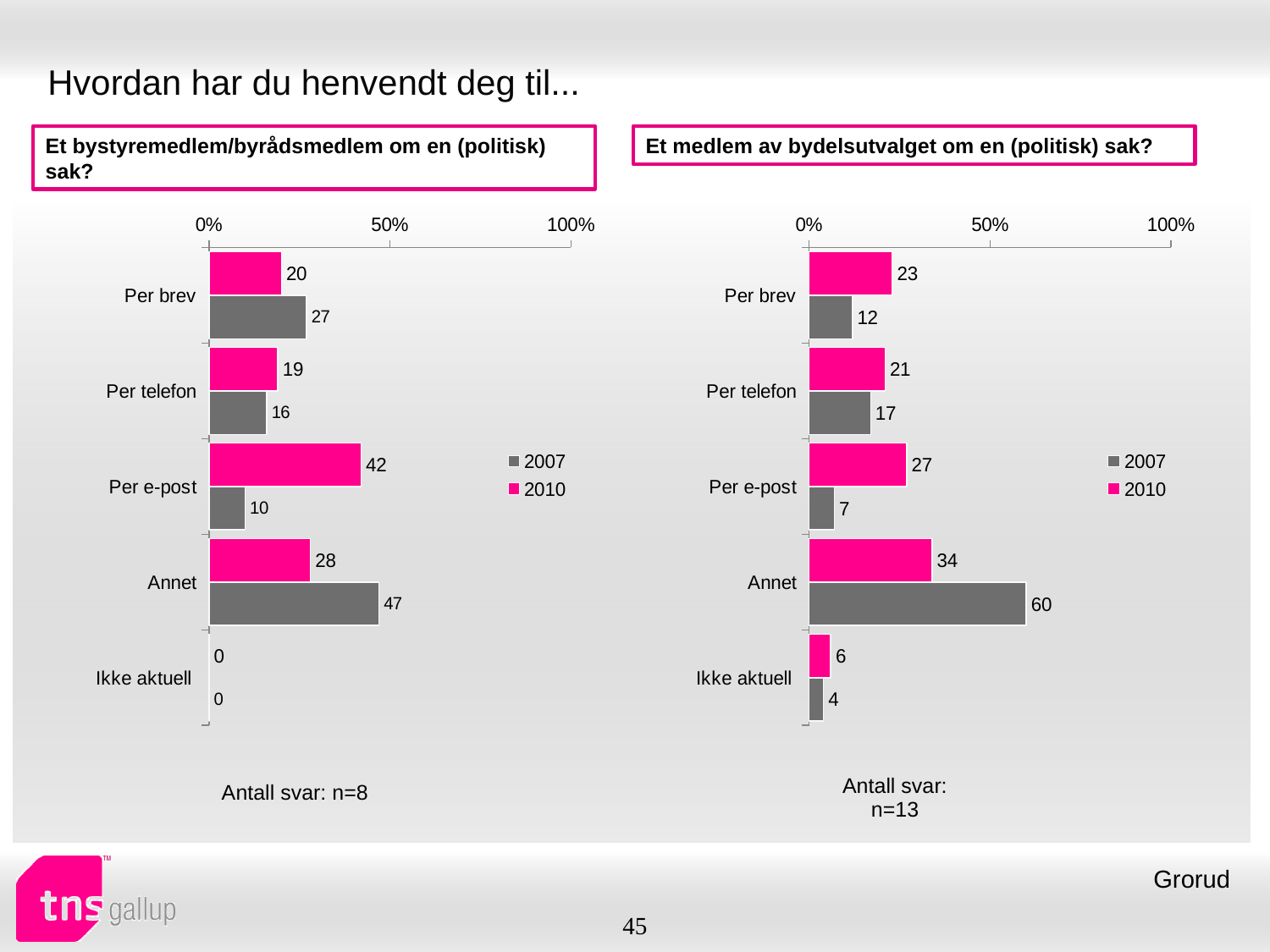
In the right chart (Et medlem av bydelsutvalget om en (politisk) sak?), which category has the lowest 2010 value? Ikke aktuell What is the number of respondents (Antall svar) stated below the right chart (Et medlem av bydelsutvalget om en (politisk) sak?)? n=13 In the left chart (Et bystyremedlem/byrådsmedlem om en (politisk) sak?), what is the 2010 value for Per e-post? 42 In the left chart (Et bystyremedlem/byrådsmedlem om en (politisk) sak?), which category has the highest 2007 value? Annet In the left chart (Et bystyremedlem/byrådsmedlem om en (politisk) sak?), what is the difference between the 2010 and 2007 values for Per e-post? 32 In the left chart (Et bystyremedlem/byrådsmedlem om en (politisk) sak?), what is the 2007 value for Ikke aktuell? 0 In the right chart (Et medlem av bydelsutvalget om en (politisk) sak?), what is the 2007 value for Annet? 60 In the right chart (Et medlem av bydelsutvalget om en (politisk) sak?), which is larger for Per brev: the 2007 value or the 2010 value? 2010 In the right chart (Et medlem av bydelsutvalget om en (politisk) sak?), is the 2007 value for Annet greater or less than 50%? greater What kind of chart is the left chart (Et bystyremedlem/byrådsmedlem om en (politisk) sak?)? Bar chart How many series does the legend of the right chart (Et medlem av bydelsutvalget om en (politisk) sak?) list? 2 How many categories are shown in the left chart (Et bystyremedlem/byrådsmedlem om en (politisk) sak?)? 5